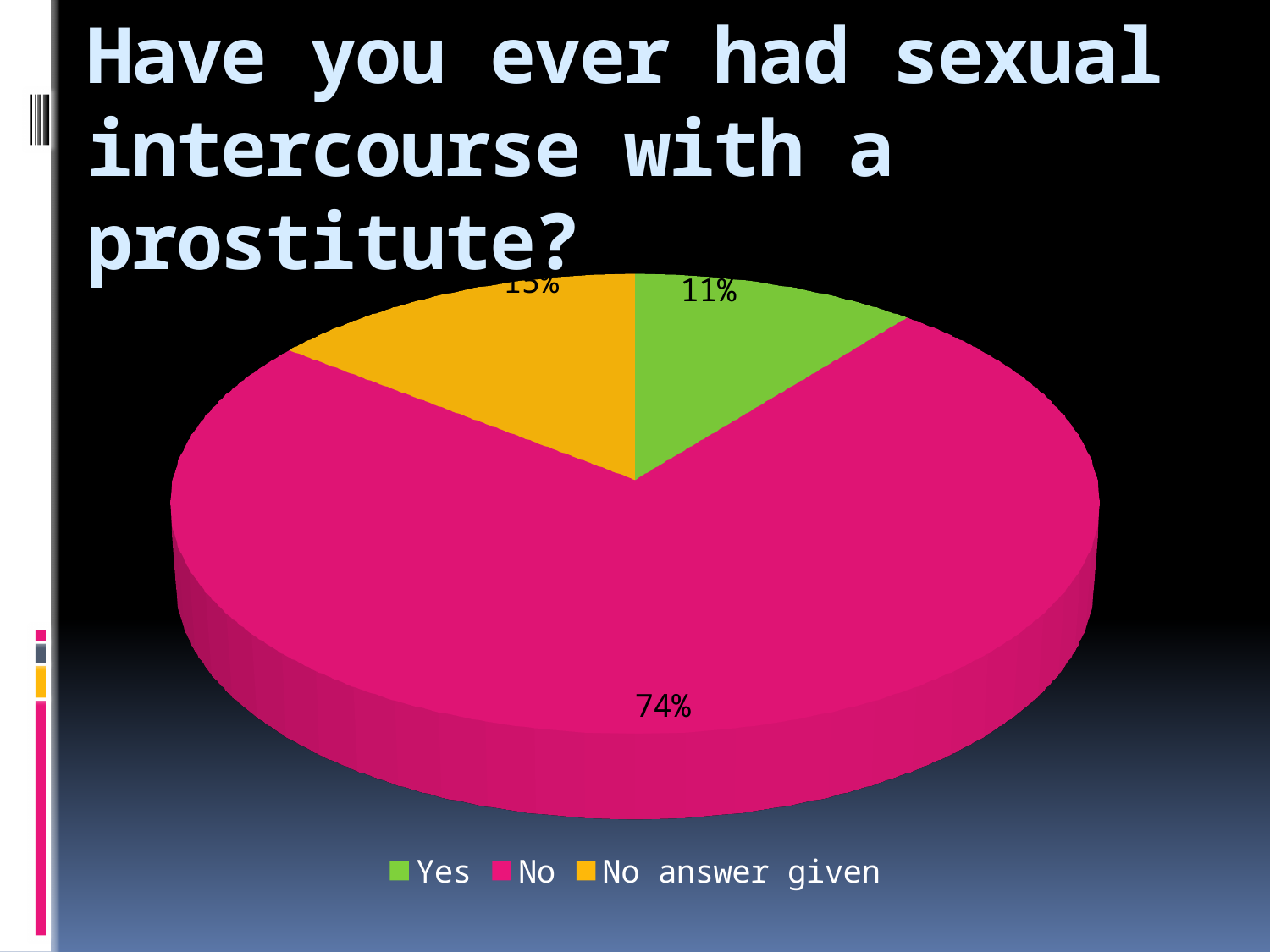
Which slice is larger, "No answer given" or "Yes"? No answer given Which response has the largest share of the pie? No Which slice is larger, "No" or "Yes"? No What percentage of respondents answered "No"? 74% How many slices does the pie chart have? 3 What is the difference in percentage points between the "No" and "Yes" slices? 63% What kind of chart is shown on the slide? pie chart How many entries does the legend list? 3 What is the title of the chart? Have you ever had sexual intercourse with a prostitute? What percentage of respondents answered "Yes"? 11% Which response has the smallest share of the pie? Yes What colour is the "No" slice? pink